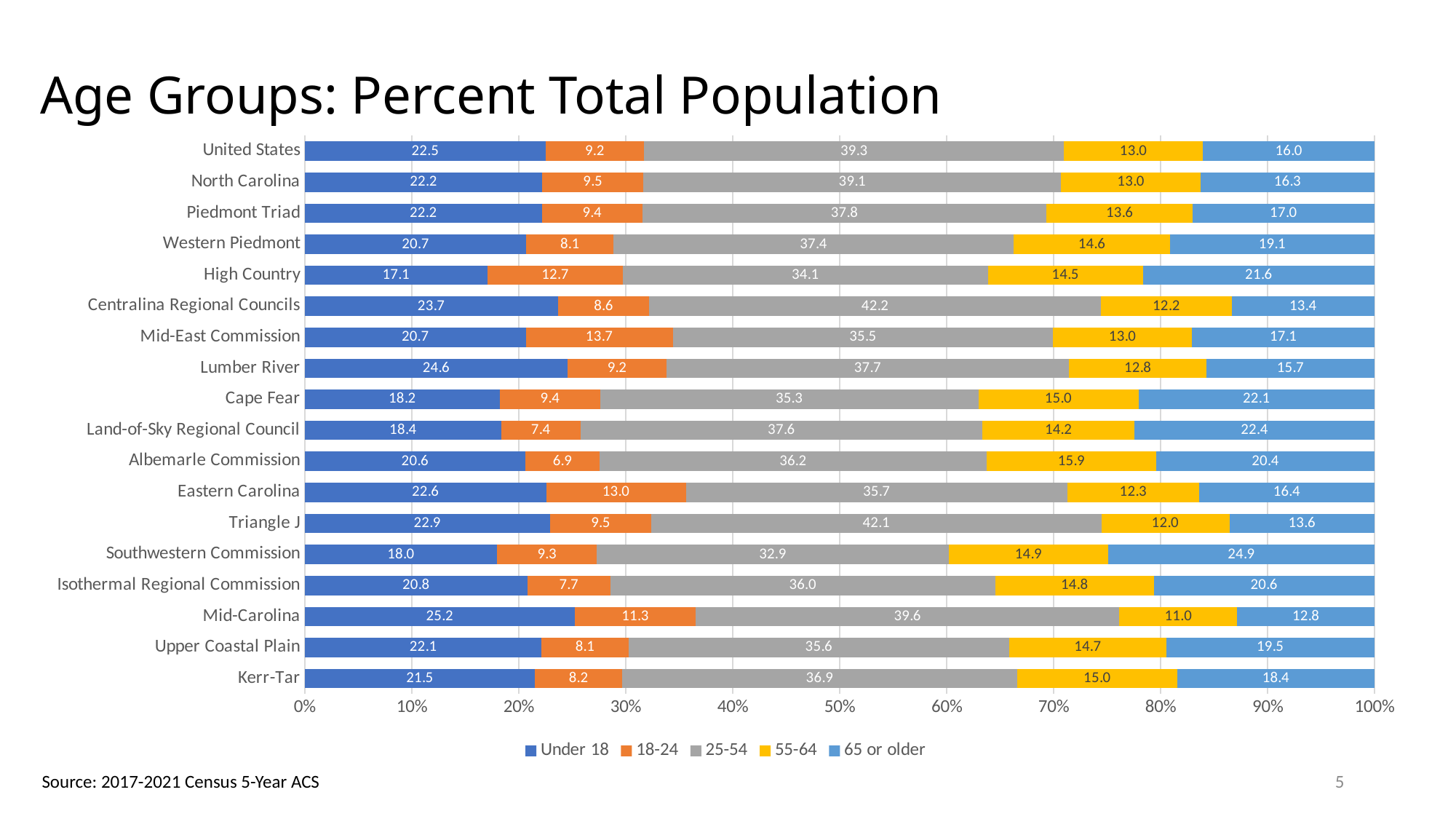
Which region has the highest value for the 65 or older group? Southwestern Commission How many age groups does the legend list? 5 What is the value for the 65 or older group in Southwestern Commission? 24.9 What is the title of the chart? Age Groups: Percent Total Population What type of chart is shown? Stacked bar chart What percentage of the United States population is in the 25-54 age group? 39.3 Which region has the lowest Under 18 value? High Country Which is larger: the 18-24 value for Mid-East Commission or for Eastern Carolina? Mid-East Commission How many regions or areas are shown on the chart? 18 What is the Under 18 value for Mid-Carolina? 25.2 Which region has the lowest 18-24 value? Albemarle Commission What is the difference between the 65 or older values for Southwestern Commission and Mid-Carolina? 12.1